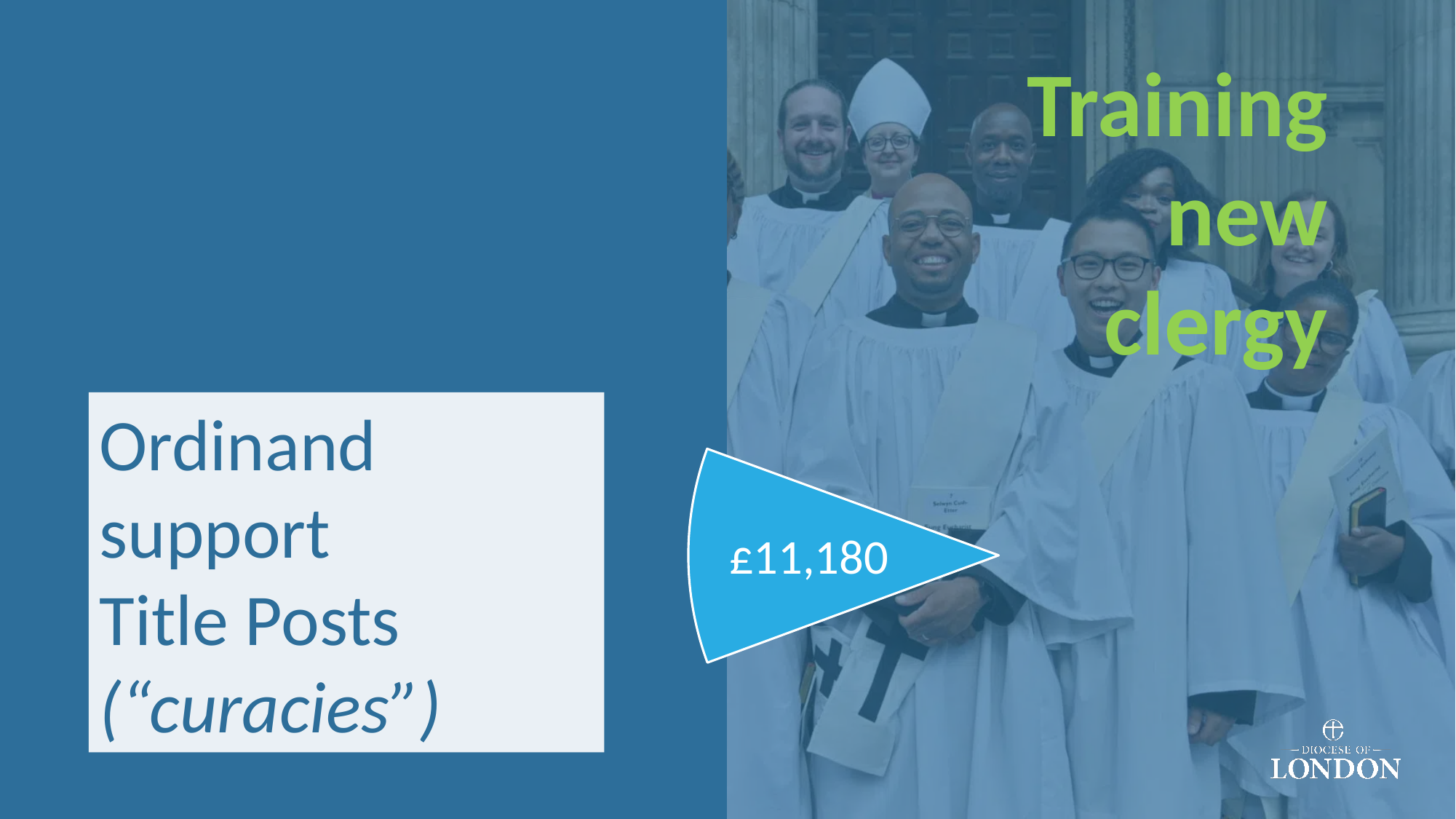
How many pie slices with a printed value are visible on the slide? 1 What is the value shown for the Ordinand support Title Posts ("curacies") slice? £11,180 What kind of chart does the wedge shape with the £11,180 label come from? pie chart What colour is the pie slice labelled £11,180? light blue What value is printed on the pie slice shown on the slide? £11,180